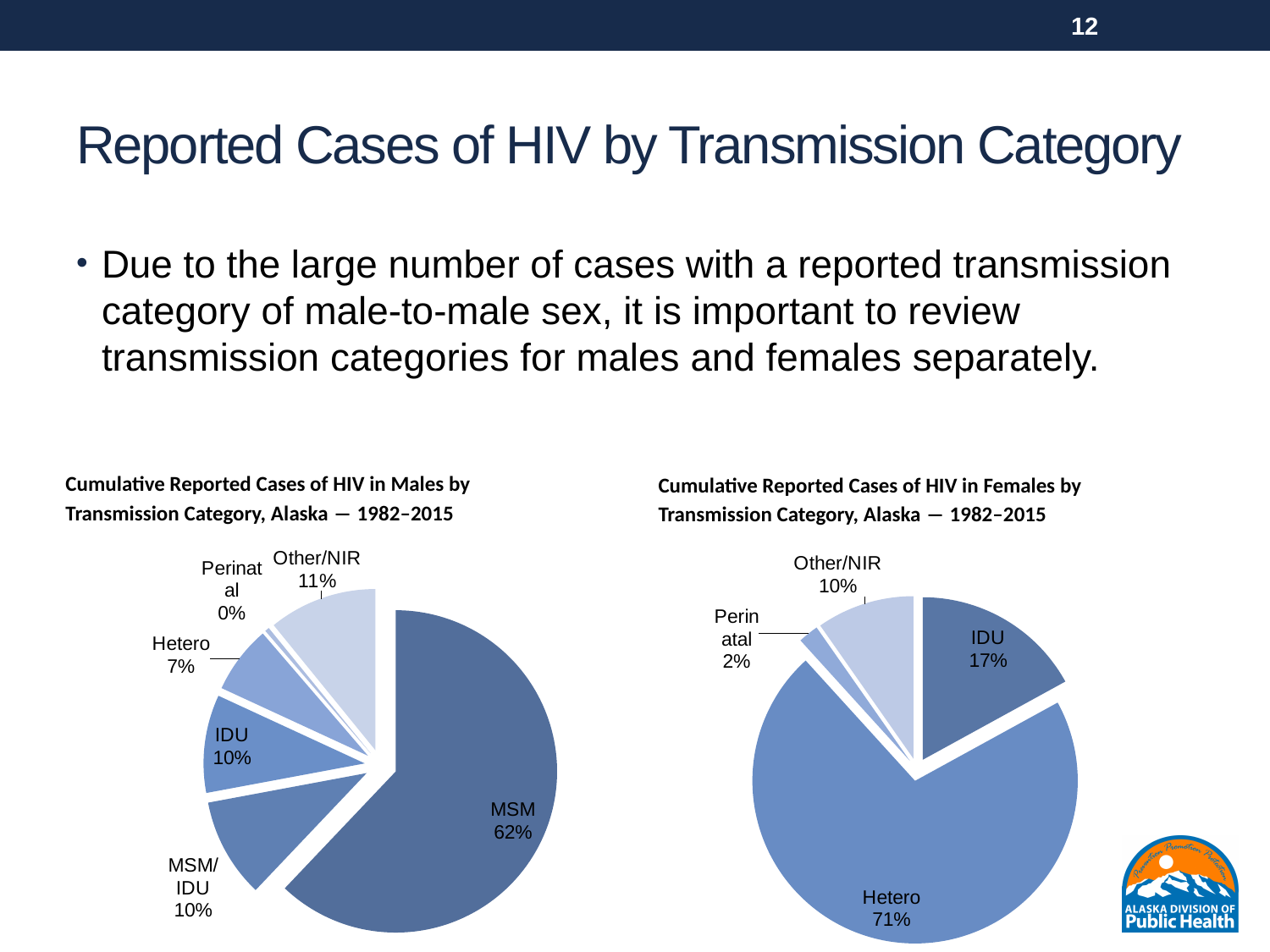
In the males chart, what share of cases is attributed to Other/NIR? 11% In the males chart, which transmission category has the largest share? MSM In the females chart, how many transmission categories are shown? 4 What kind of chart is used for the Cumulative Reported Cases of HIV in Males chart? Pie chart In the females chart, what share of cases is attributed to IDU? 17% In the females chart, what share of cases is attributed to Hetero? 71% Which is larger: the Hetero share in the females chart or the MSM share in the males chart? Hetero share in the females chart In the males chart, how many transmission categories are shown? 6 In the males chart, which transmission category has the smallest share? Perinatal In the males chart, what is the difference between the MSM share and the Hetero share? 55% In the males chart, what share of cases is attributed to MSM? 62% In the females chart, which transmission category has the smallest share? Perinatal